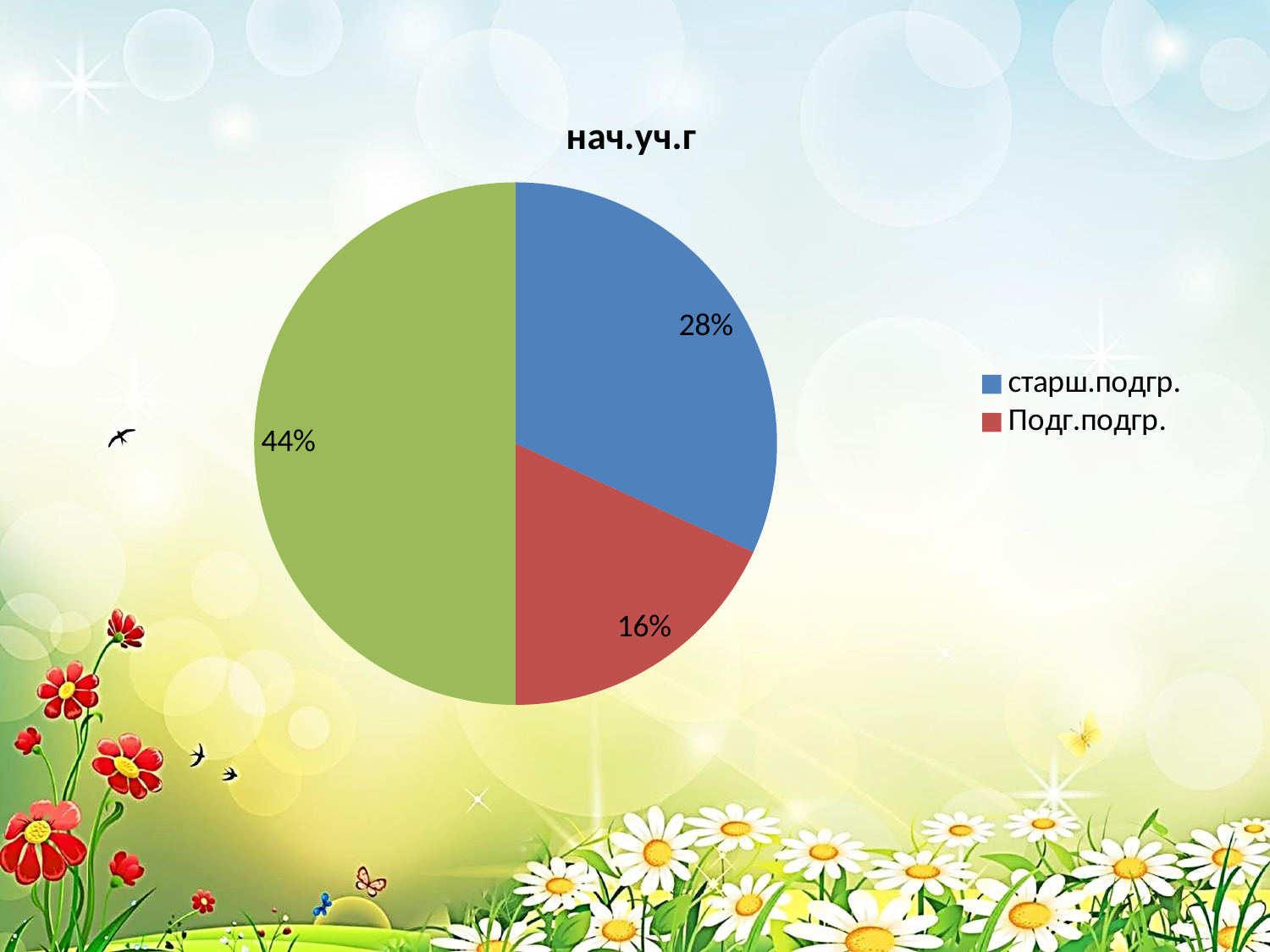
What is the title of the chart? нач.уч.г What percentage is shown for Подг.подгр.? 16% How many entries does the legend list? 2 Which slice of the pie is the largest? the green slice (44%) How many slices does the pie chart have? 3 What percentage is shown for старш.подгр.? 28% What colour represents старш.подгр. in the chart? blue Which slice of the pie is the smallest? Подг.подгр. (16%) What percentage is shown on the green slice of the pie? 44% What is the difference in percentage points between старш.подгр. and Подг.подгр.? 12 percentage points Which of the two legend categories, старш.подгр. or Подг.подгр., has the larger share? старш.подгр. What type of chart is shown on the slide? pie chart